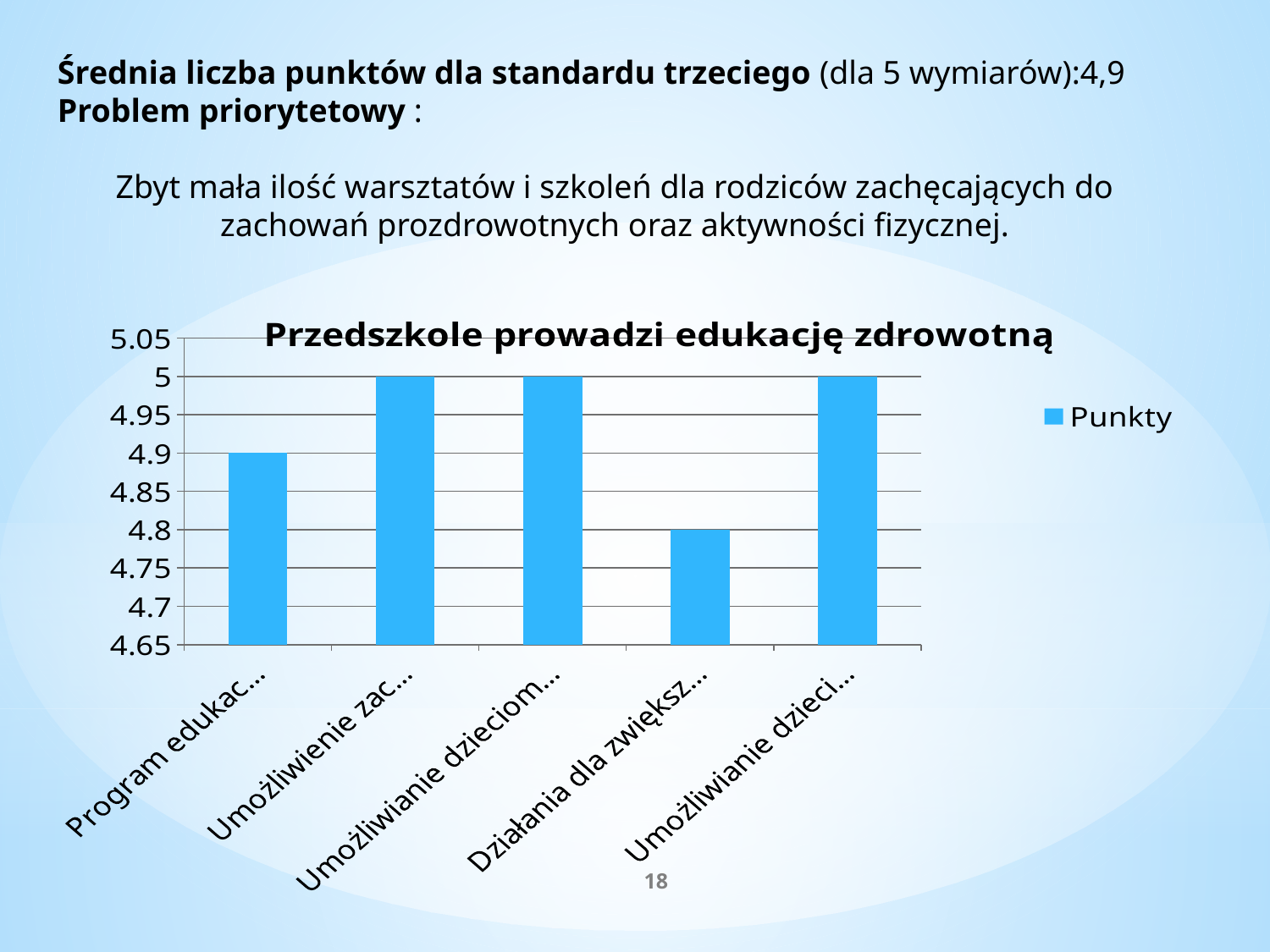
What is the value of the second bar ("Umożliwienie zac...")? 5 What is the value of the fourth bar ("Działania dla zwiększ...")? 4.8 Is the value for the fourth bar ("Działania dla zwiększ...") greater or less than 4.85? less What is the difference between the value of the first bar ("Program edukac...") and the fourth bar ("Działania dla zwiększ...")? 0.1 What is the value of the first bar ("Program edukac...")? 4.9 What is the title of the chart? Przedszkole prowadzi edukację zdrowotną What kind of chart is shown on the slide? bar chart What is the name of the series shown in the chart legend? Punkty How many bars (categories) does the chart show? 5 How many series does the chart legend list? 1 Which category has the lowest value in the chart? Działania dla zwiększ... (the fourth bar) Which is larger: the value of the first bar ("Program edukac...") or the fourth bar ("Działania dla zwiększ...")? Program edukac... (the first bar)